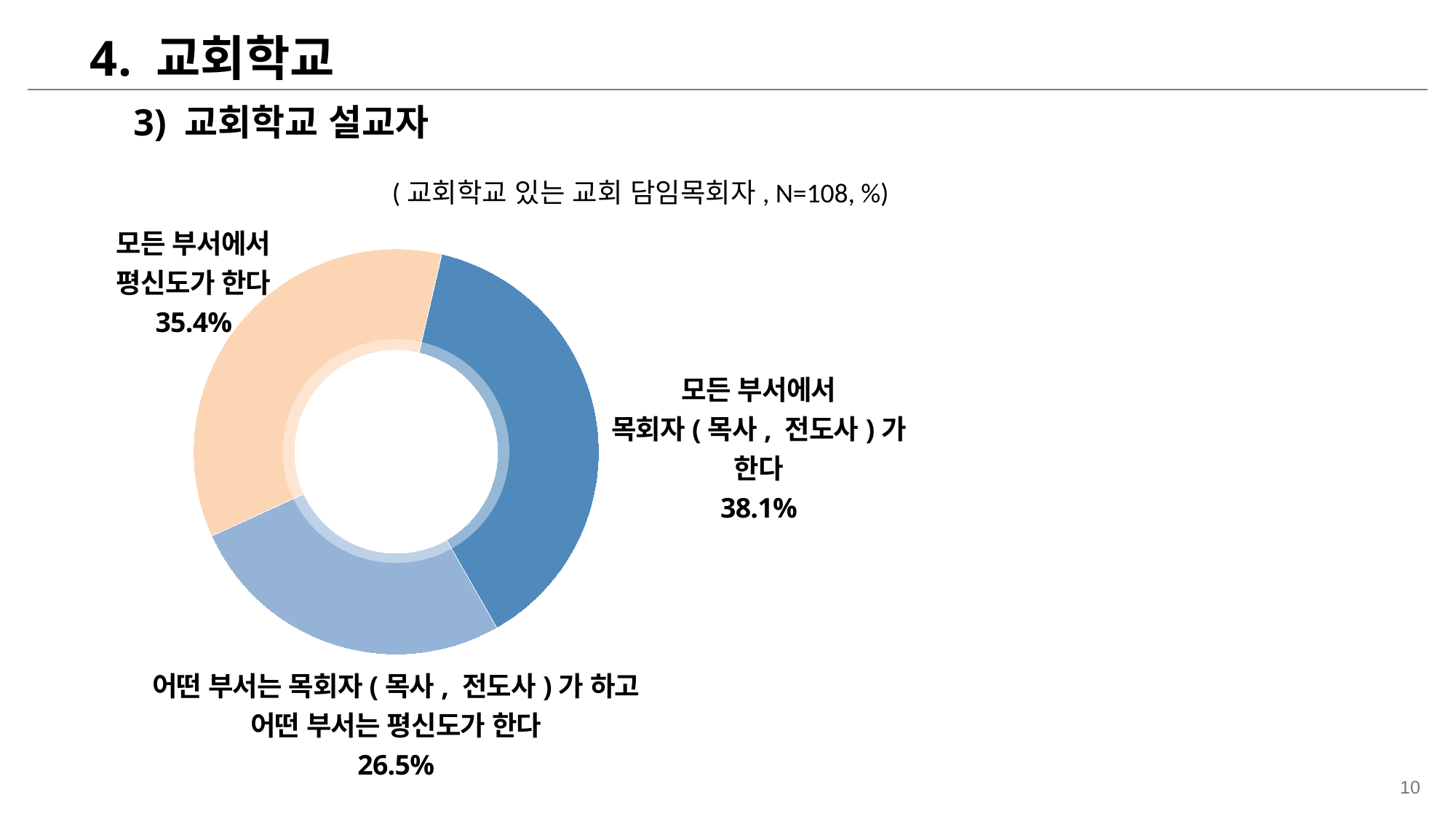
What colour is the slice for '모든 부서에서 목회자(목사, 전도사)가 한다'? Dark blue What percentage is shown for '모든 부서에서 목회자(목사, 전도사)가 한다'? 38.1% What is the sample size (N) stated above the chart? N=108 Which category has the smallest share in the chart? 어떤 부서는 목회자(목사, 전도사)가 하고 어떤 부서는 평신도가 한다 What percentage is shown for '모든 부서에서 평신도가 한다'? 35.4% What percentage is shown for '어떤 부서는 목회자(목사, 전도사)가 하고 어떤 부서는 평신도가 한다'? 26.5% What is the difference in percentage points between '모든 부서에서 평신도가 한다' and '어떤 부서는 목회자(목사, 전도사)가 하고 어떤 부서는 평신도가 한다'? 8.9 percentage points Which category has the largest share in the chart? 모든 부서에서 목회자(목사, 전도사)가 한다 What is the difference in percentage points between '모든 부서에서 목회자(목사, 전도사)가 한다' and '모든 부서에서 평신도가 한다'? 2.7 percentage points Which is larger: the share for '모든 부서에서 평신도가 한다' or the share for '어떤 부서는 목회자(목사, 전도사)가 하고 어떤 부서는 평신도가 한다'? 모든 부서에서 평신도가 한다 How many categories are shown in the chart? 3 What kind of chart is shown on the slide? Donut (pie) chart